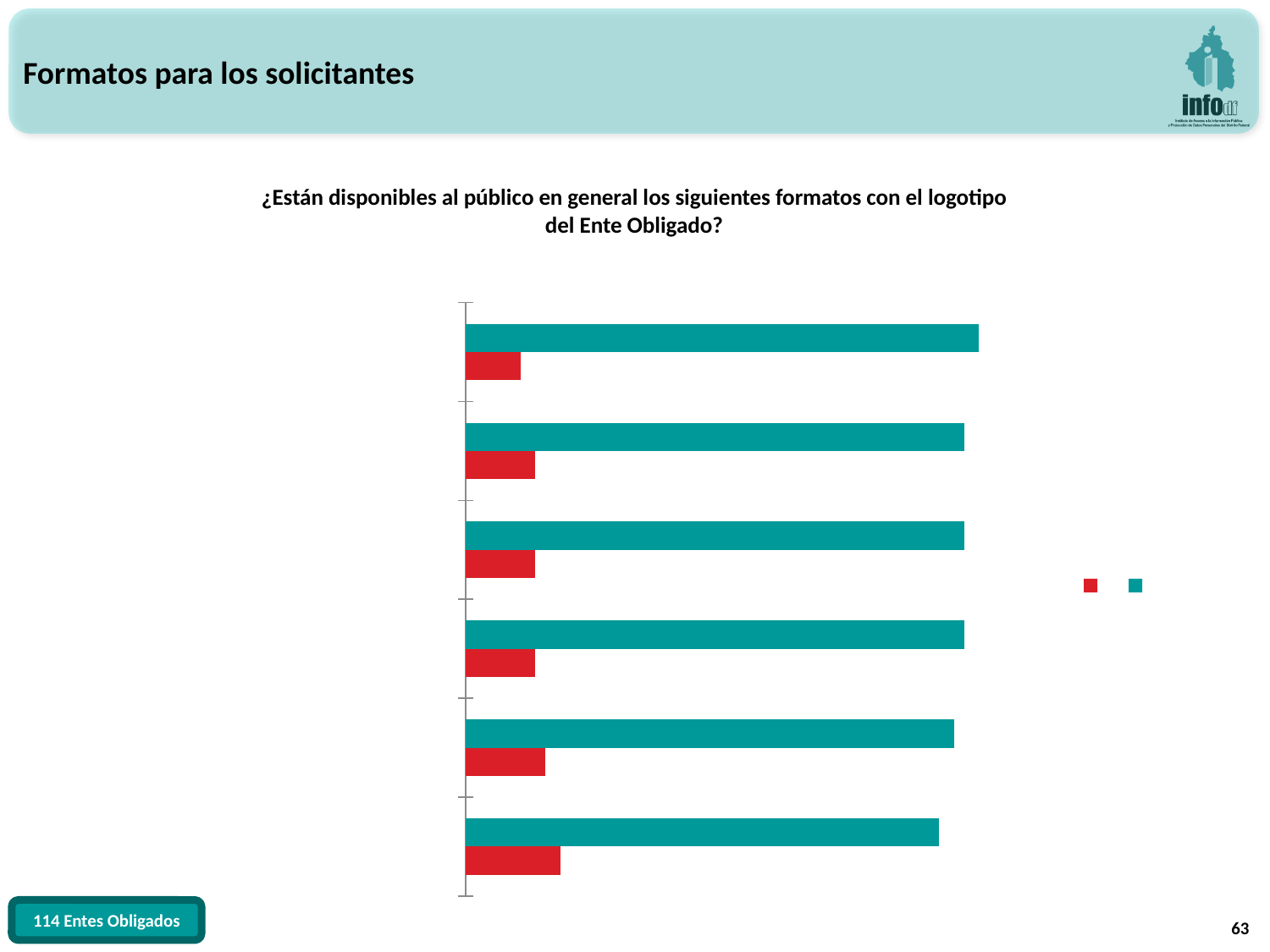
Which group of bars has the longest red bar? the bottom group What kind of chart is shown on the slide? bar chart Are the bars in the chart horizontal or vertical? horizontal Which group of bars has the shortest red bar? the topmost group How many groups of bars does the chart contain? 6 How many series does the legend list? 2 What question is used as the title of the chart? ¿Están disponibles al público en general los siguientes formatos con el logotipo del Ente Obligado? What two colours are used for the bars in the chart? teal and red In the topmost group of bars, which bar is longer, the teal one or the red one? the teal one In the bottom group of bars, which bar is longer, the teal one or the red one? the teal one Which group of bars has the longest teal bar? the topmost group Going from the top group to the bottom group, do the teal bars get longer or shorter? shorter